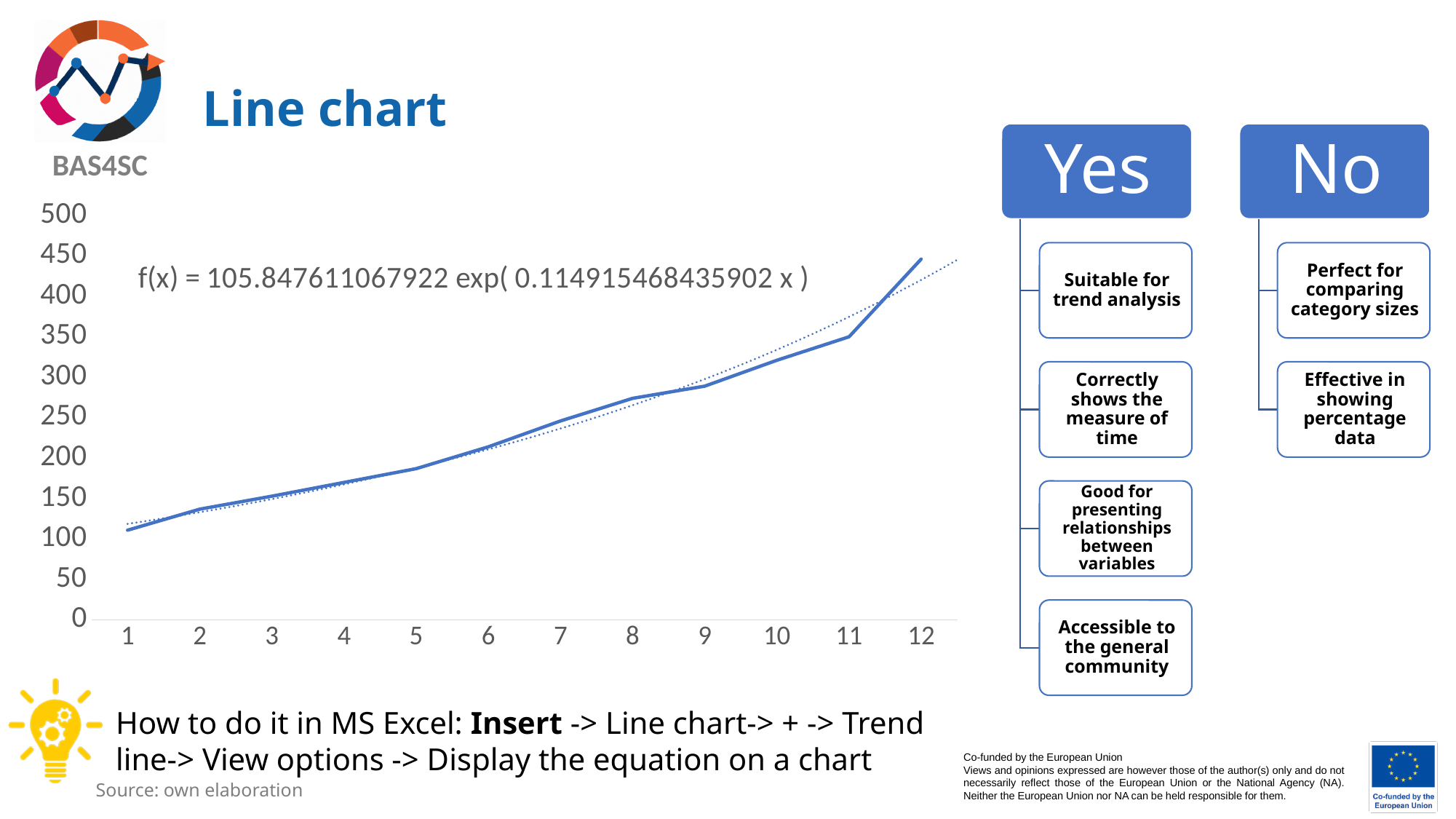
How many data points are plotted along the x axis of the line chart? 12 What kind of chart is shown on the slide? line chart Which is larger in the line chart, the value at x = 5 or the value at x = 9? x = 9 At which x value does the line chart have its lowest value? 1 Is the value at x = 1 in the line chart greater or less than 150? less Do the values in the line chart rise or fall as x increases from 1 to 12? rise Is the value at x = 12 in the line chart greater or less than 400? greater Is the value at x = 11 in the line chart greater or less than 400? less At which x value does the line chart reach its highest value? 12 What is the highest tick value shown on the y axis of the line chart? 500 What is the trendline equation displayed on the line chart? f(x) = 105.847611067922 exp( 0.114915468435902 x )